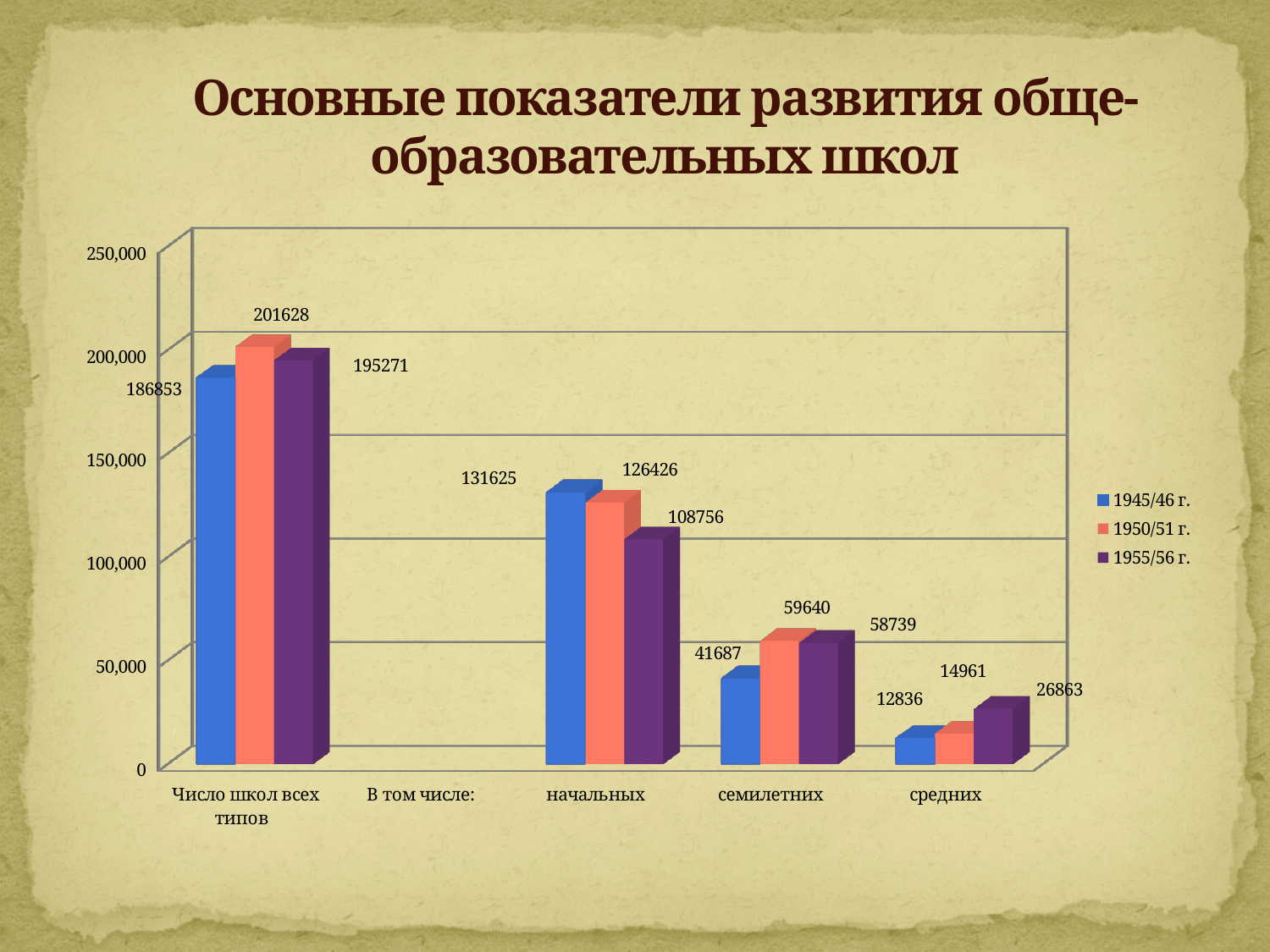
What kind of chart is shown on the slide? bar chart Which series has the highest value in the category 'Число школ всех типов'? 1950/51 г. What is the difference between the 1950/51 г. and 1945/46 г. values in the category 'Число школ всех типов'? 14775 What is the value for 1950/51 г. in the category 'Число школ всех типов'? 201628 How many series does the legend list? 3 What is the value for 1955/56 г. in the category 'средних'? 26863 Do the values for the category 'начальных' rise or fall from 1945/46 г. to 1955/56 г.? fall Which series has the lowest value in the category 'средних'? 1945/46 г. Which is larger in the category 'семилетних': the value for 1950/51 г. or for 1955/56 г.? 1950/51 г. Is the value for 1945/46 г. in the category 'начальных' greater or less than 100,000? greater What is the value for 1955/56 г. in the category 'начальных'? 108756 What is the value for 1945/46 г. in the category 'семилетних'? 41687